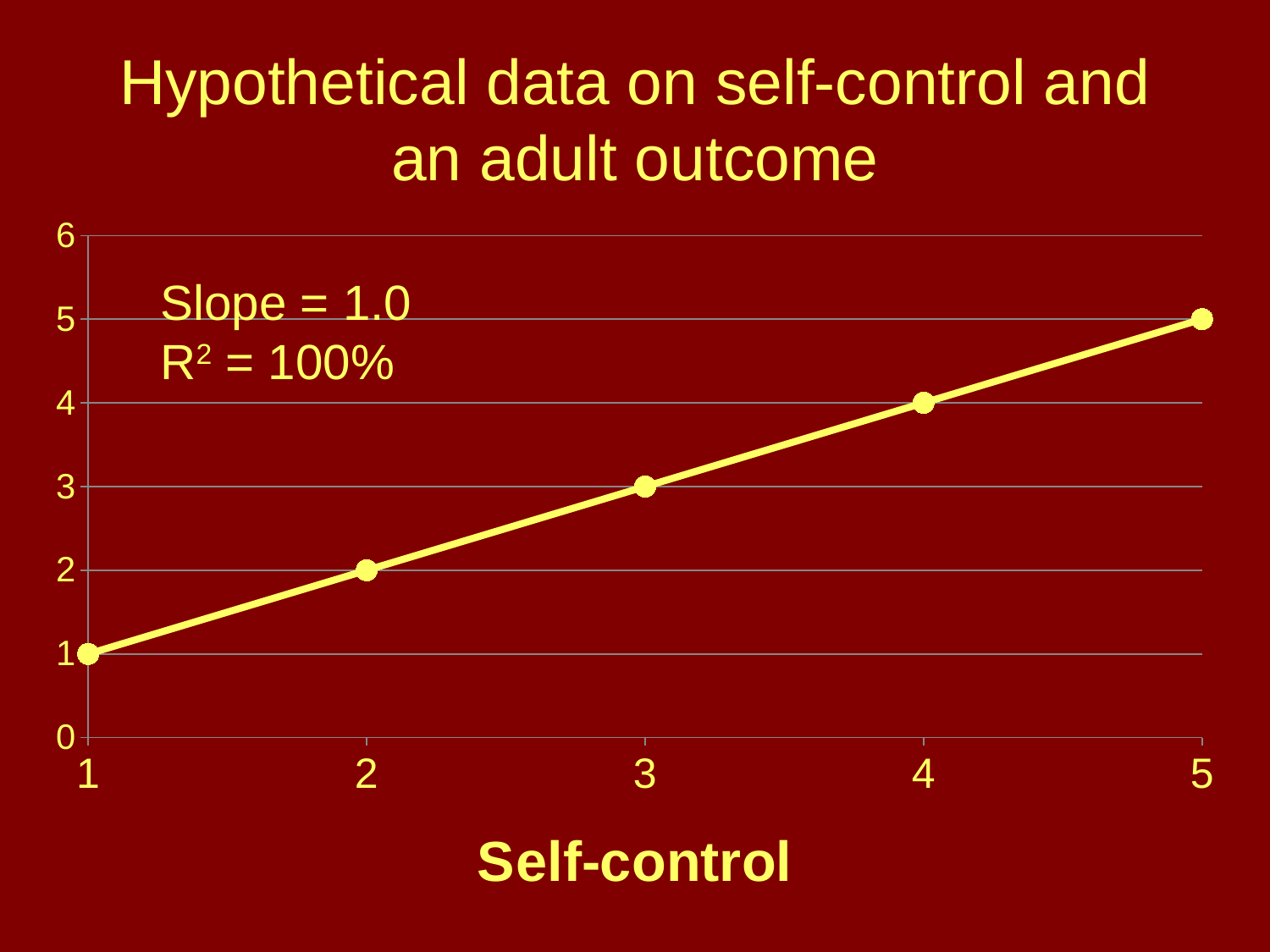
Do the plotted values rise or fall as self-control increases along the x axis? rise What is the label of the x axis? Self-control At which self-control value is the plotted outcome highest? 5 What is the difference between the plotted values at self-control 4 and self-control 2? 2 What is the title of the chart? Hypothetical data on self-control and an adult outcome What is the plotted value when self-control is 3? 3 At which self-control value is the plotted outcome lowest? 1 What is the plotted value when self-control is 1? 1 What is the plotted value when self-control is 5? 5 How many data points are plotted on the line? 5 Which is larger, the plotted value at self-control 2 or at self-control 4? self-control 4 What kind of chart is shown on the slide? line chart